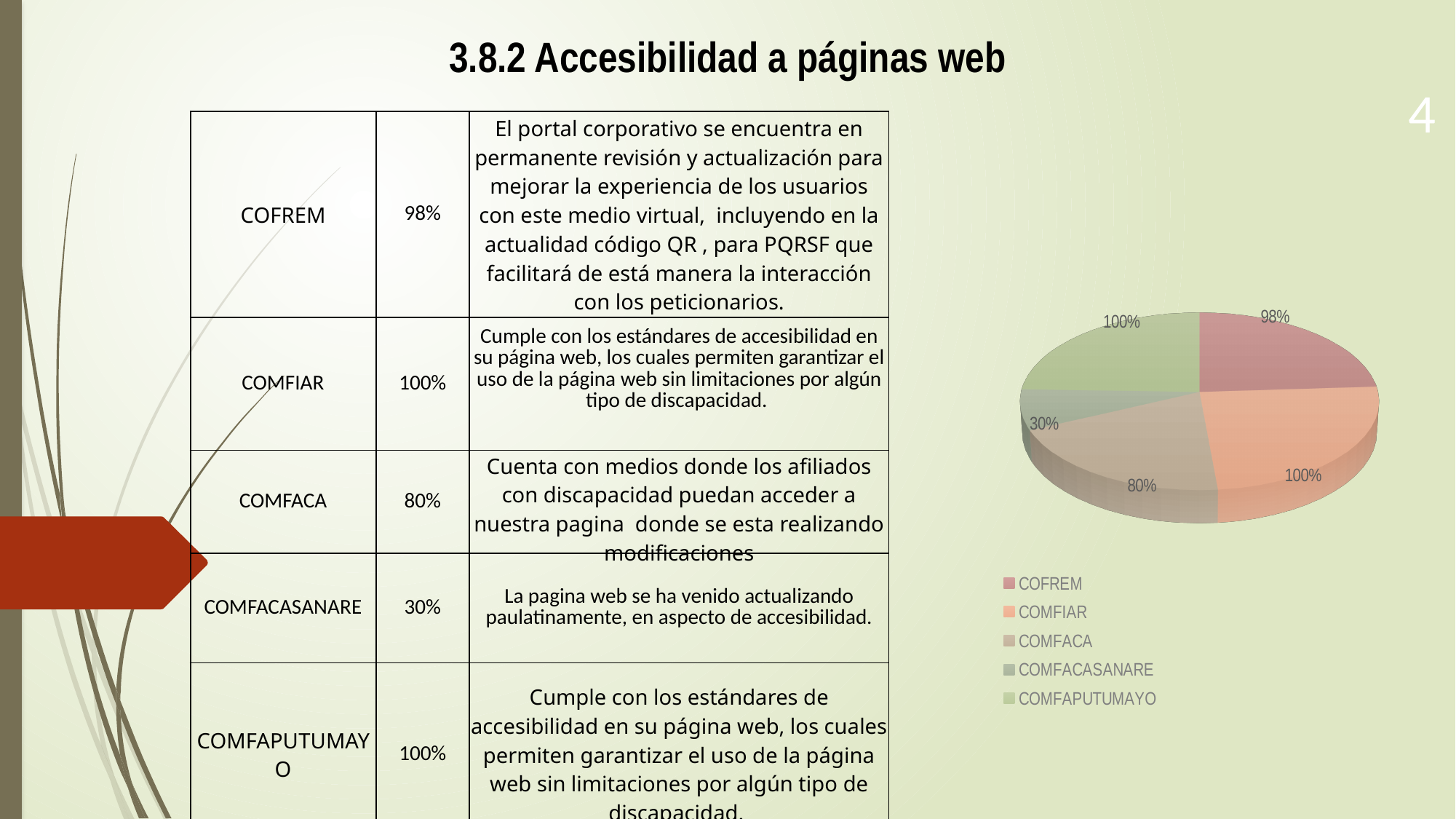
Which category has the lowest value in the pie chart? COMFACASANARE What value is shown for COMFIAR in the pie chart? 100% What value is shown for COFREM in the pie chart? 98% What value is shown for COMFACA in the pie chart? 80% What type of chart is shown on the slide? pie chart What value is shown for COMFAPUTUMAYO in the pie chart? 100% How many entries does the legend of the pie chart list? 5 Which has a larger value, COFREM or COMFACA? COFREM What value is shown for COMFACASANARE in the pie chart? 30% What is the difference between the values for COFREM and COMFACASANARE? 68 percentage points How many categories does the pie chart have? 5 What is the difference between the values for COMFIAR and COMFACA? 20 percentage points